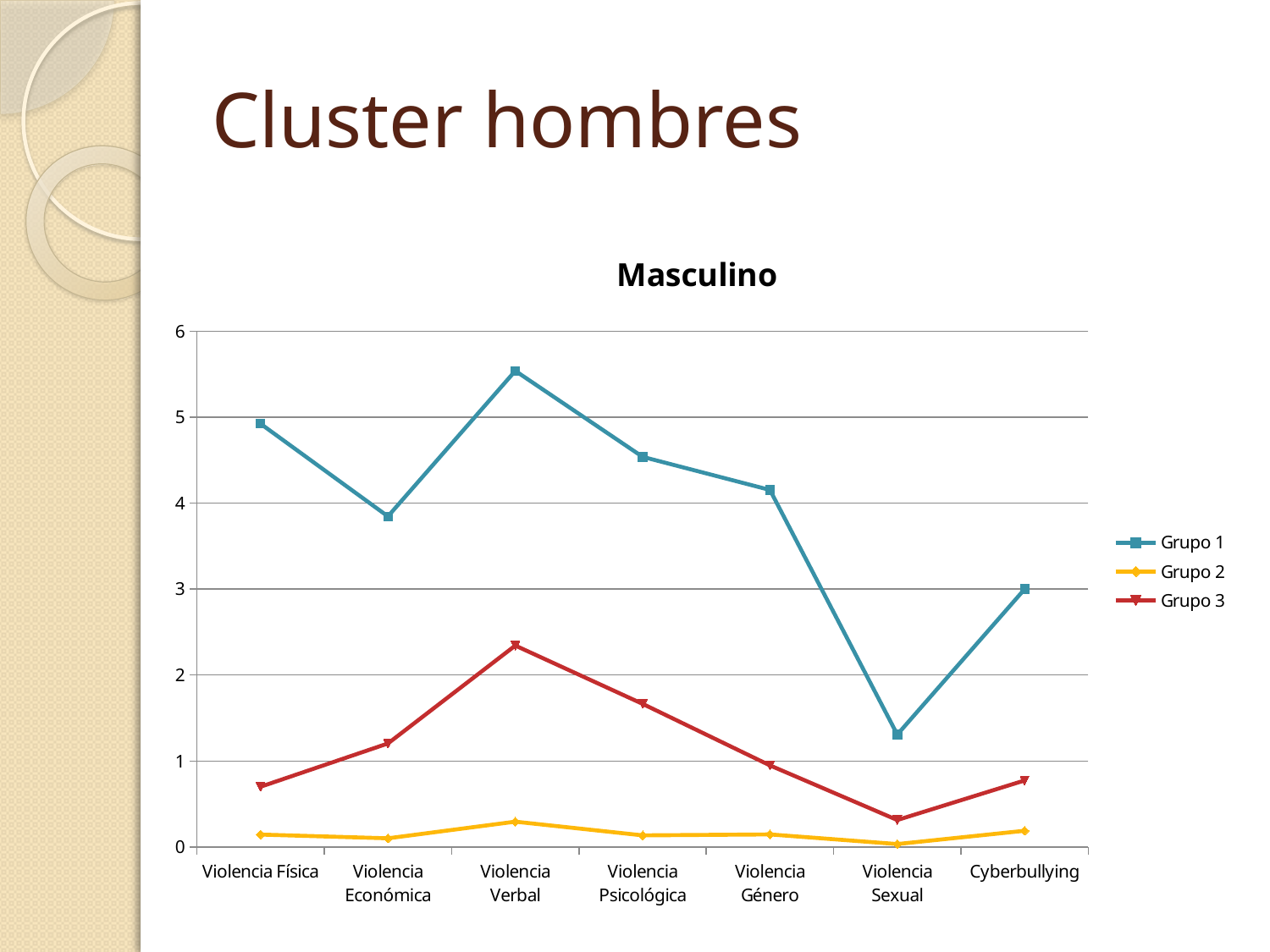
For which category does Grupo 3 reach its highest value? Violencia Verbal What is the title of the chart? Masculino How many series does the legend list? 3 What type of chart is shown on the slide? Line chart Which series has the larger value at Violencia Verbal, Grupo 1 or Grupo 3? Grupo 1 Is the value for Grupo 1 at Violencia Sexual greater or less than 2? less For which category does Grupo 1 have its lowest value? Violencia Sexual How many categories are shown on the x axis? 7 Is the value for Grupo 3 at Violencia Verbal greater or less than 2? greater Does the Grupo 1 line rise or fall from Violencia Género to Violencia Sexual? Falls For which category does Grupo 1 reach its highest value? Violencia Verbal Is the value for Grupo 1 at Violencia Física greater or less than 4? greater